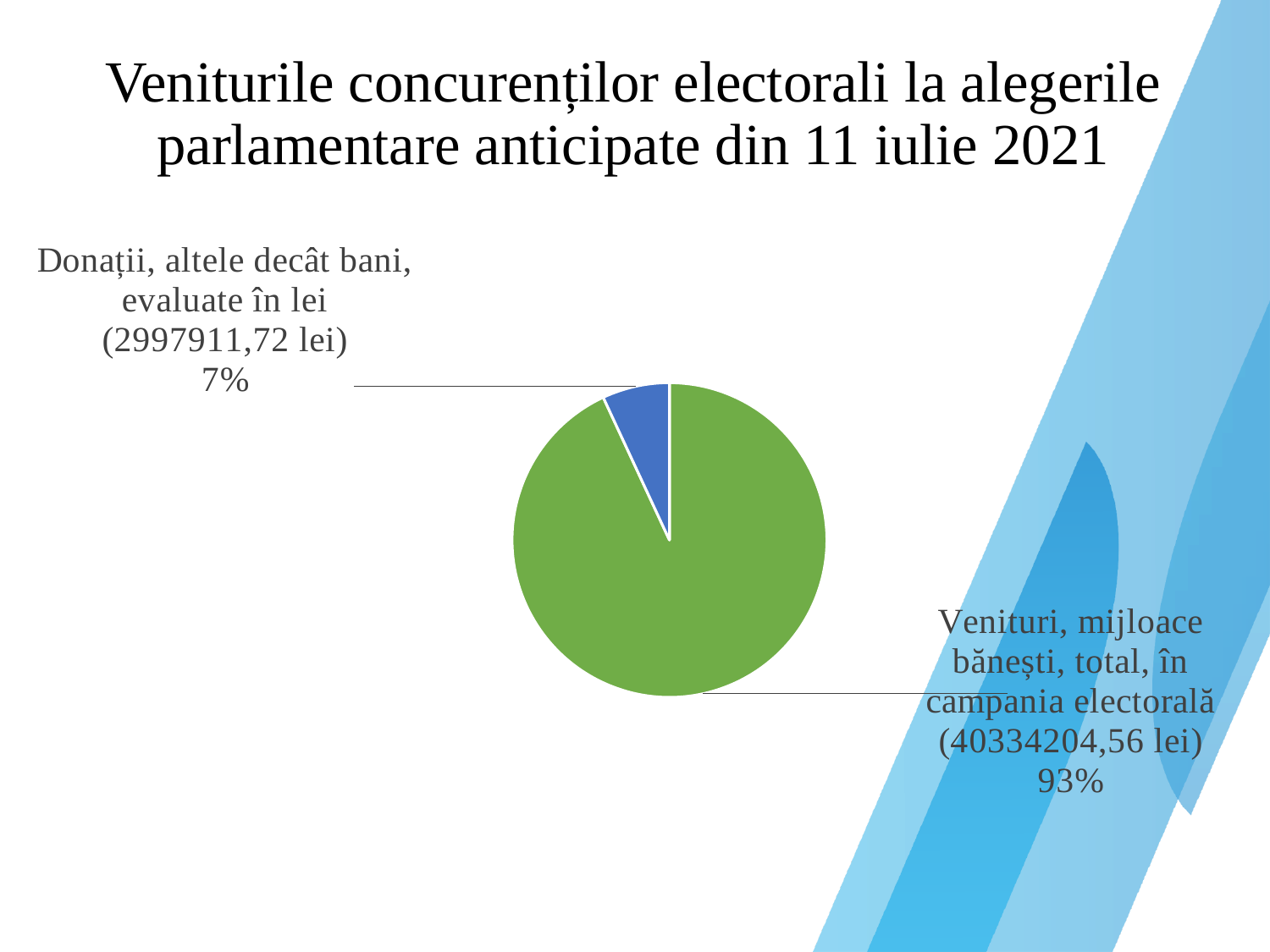
Which slice of the pie chart is the smallest? Donații, altele decât bani, evaluate în lei What value in lei is shown for "Donații, altele decât bani, evaluate în lei"? 2997911,72 lei Which slice of the pie chart is the largest? Venituri, mijloace bănești, total, în campania electorală What share of the pie does "Donații, altele decât bani, evaluate în lei" represent? 7% What is the difference in percentage points between the two slices of the pie chart? 86 percentage points What kind of chart is shown on the slide? pie chart How many slices does the pie chart have? 2 What colour is the slice for "Venituri, mijloace bănești, total, în campania electorală"? green What is the title of the slide containing the pie chart? Veniturile concurenților electorali la alegerile parlamentare anticipate din 11 iulie 2021 What share of the pie does "Venituri, mijloace bănești, total, în campania electorală" represent? 93% What value in lei is shown for "Venituri, mijloace bănești, total, în campania electorală"? 40334204,56 lei Which is larger: the share for "Venituri, mijloace bănești, total, în campania electorală" or the share for "Donații, altele decât bani, evaluate în lei"? Venituri, mijloace bănești, total, în campania electorală